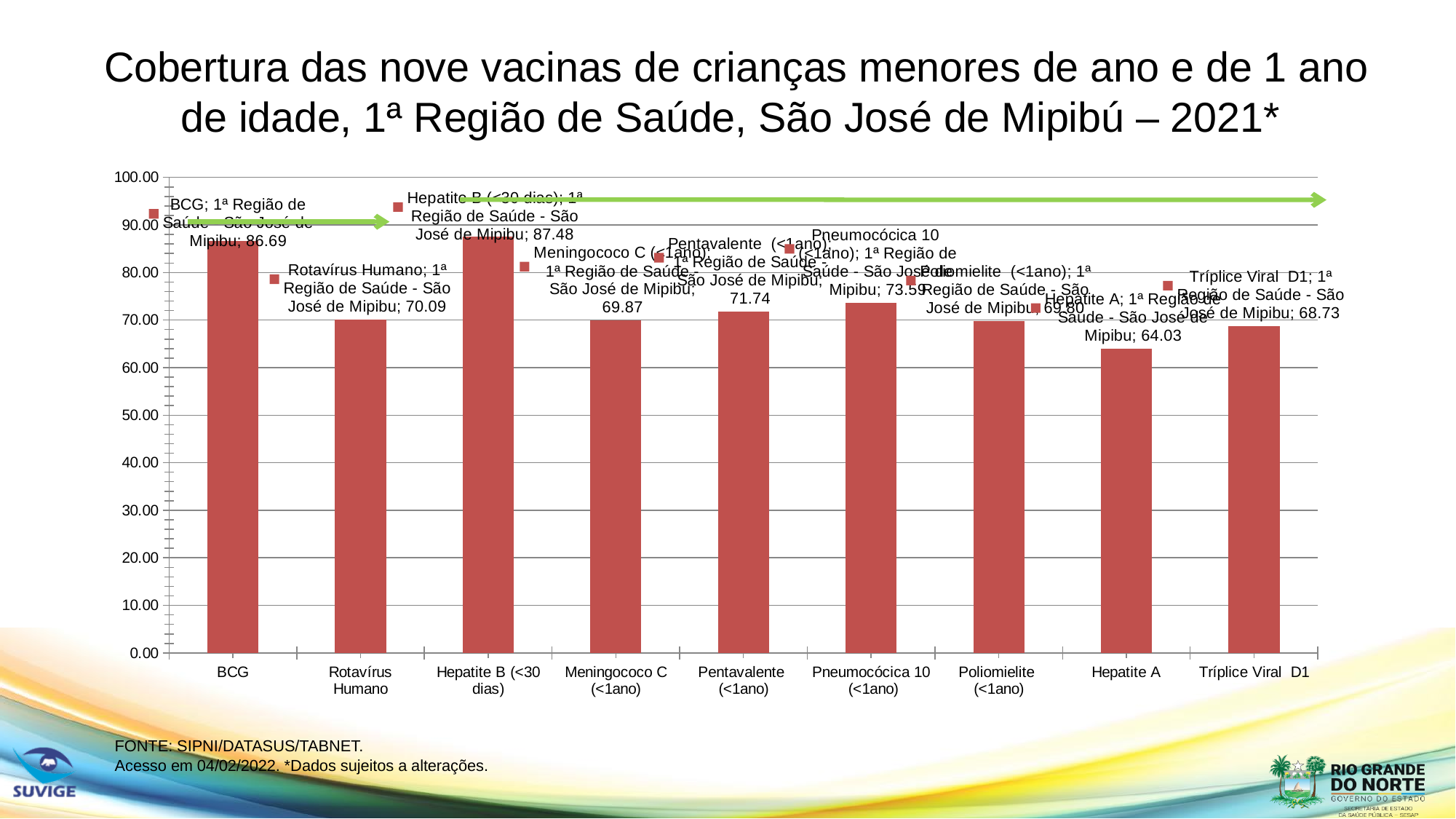
Which vaccine has the lowest value? Hepatite A What is the value for Hepatite A? 64.03 What is the value for Pneumocócica 10 (<1ano)? 73.59 Which vaccine has the highest value? Hepatite B (<30 dias) What is the difference between the values for Hepatite B (<30 dias) and Hepatite A? 23.45 Which is larger, the value for Pentavalente (<1ano) or the value for Meningococo C (<1ano)? Pentavalente (<1ano) Is the value for Rotavírus Humano greater or less than 80.00? less What is the source cited below the chart? SIPNI/DATASUS/TABNET How many vaccines are shown on the x axis? 9 What is the value for Tríplice Viral D1? 68.73 What is the value for BCG? 86.69 What kind of chart is shown on the slide? bar chart